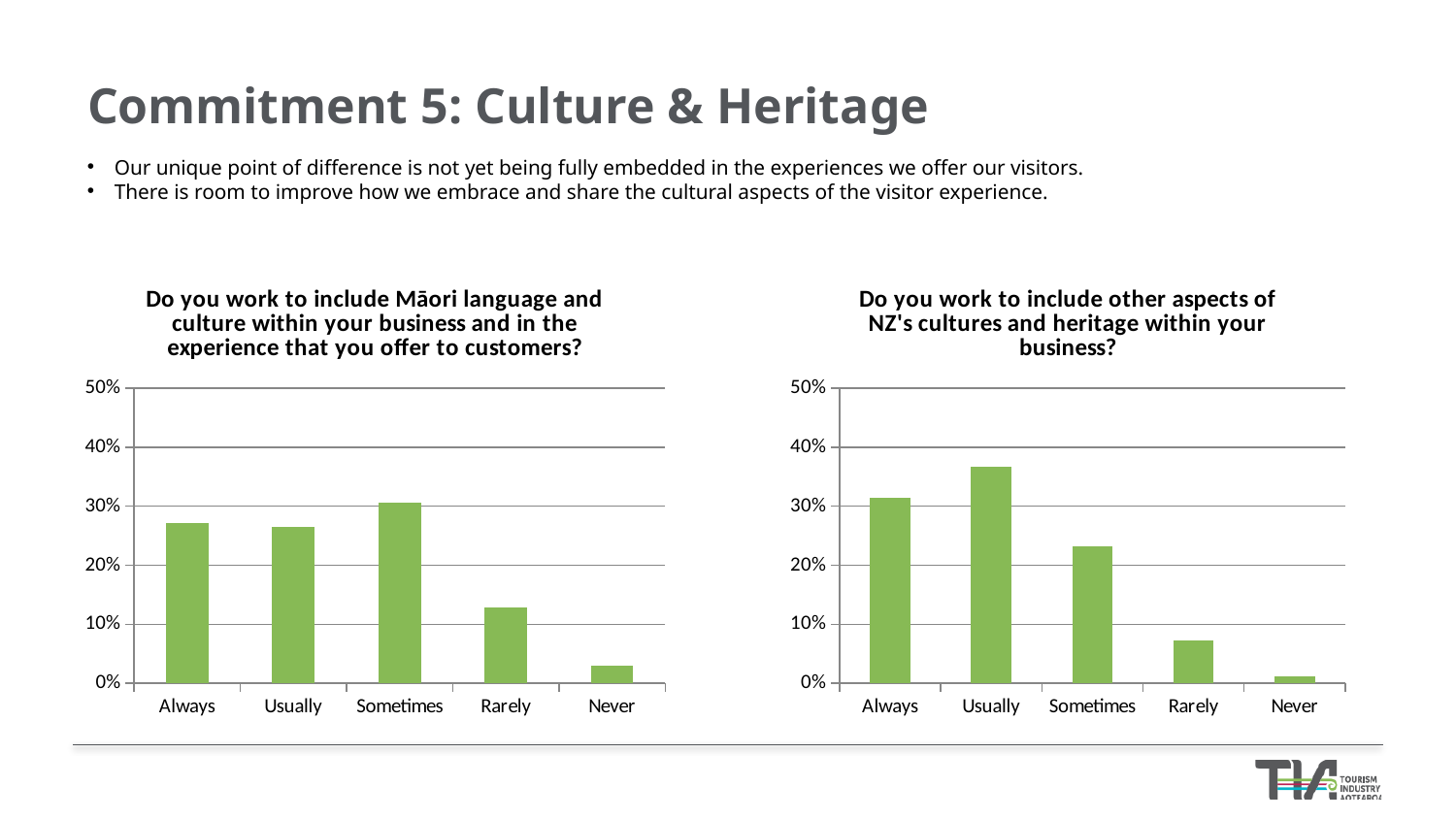
In the right chart (other aspects of NZ's cultures and heritage), which category has the lowest value? Never In the right chart (other aspects of NZ's cultures and heritage), which is larger, the value for Usually or the value for Sometimes? Usually In the left chart (Māori language and culture), is the value for Rarely greater or less than 20%? less In the right chart (other aspects of NZ's cultures and heritage), is the value for Rarely greater or less than 10%? less In the left chart (Māori language and culture), which category has the lowest value? Never In the left chart (Māori language and culture), which category has the highest value? Sometimes In the right chart (other aspects of NZ's cultures and heritage), is the value for Always greater or less than 30%? greater What kind of chart is the right chart (other aspects of NZ's cultures and heritage)? Bar chart In the right chart (other aspects of NZ's cultures and heritage), which category has the highest value? Usually In the left chart (Māori language and culture), which is larger, the value for Sometimes or the value for Rarely? Sometimes How many categories are shown on the x axis of the left chart (Māori language and culture)? 5